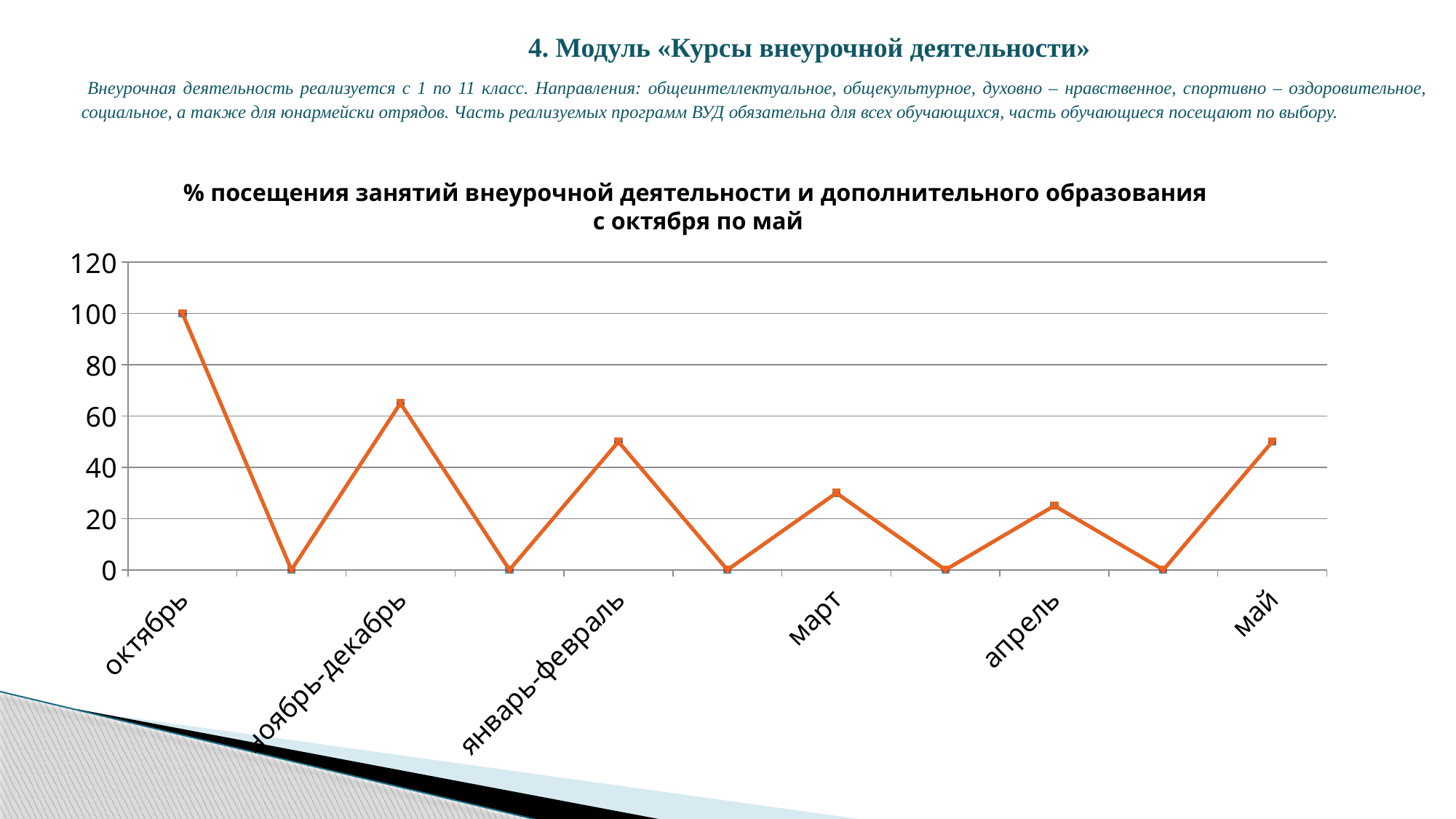
How many data points are plotted on the line? 11 Which is larger, the value for ноябрь-декабрь or the value for март? ноябрь-декабрь Is the value for май greater or less than 40? greater Which is larger, the value for октябрь or the value for май? октябрь What is the title of the chart? % посещения занятий внеурочной деятельности и дополнительного образования с октября по май What kind of chart is shown on the slide? line chart Which category has the highest value? октябрь What is the value for октябрь? 100 What is the highest value shown on the vertical axis? 120 Is the value for март greater or less than 40? less Is the value for апрель greater or less than 20? greater